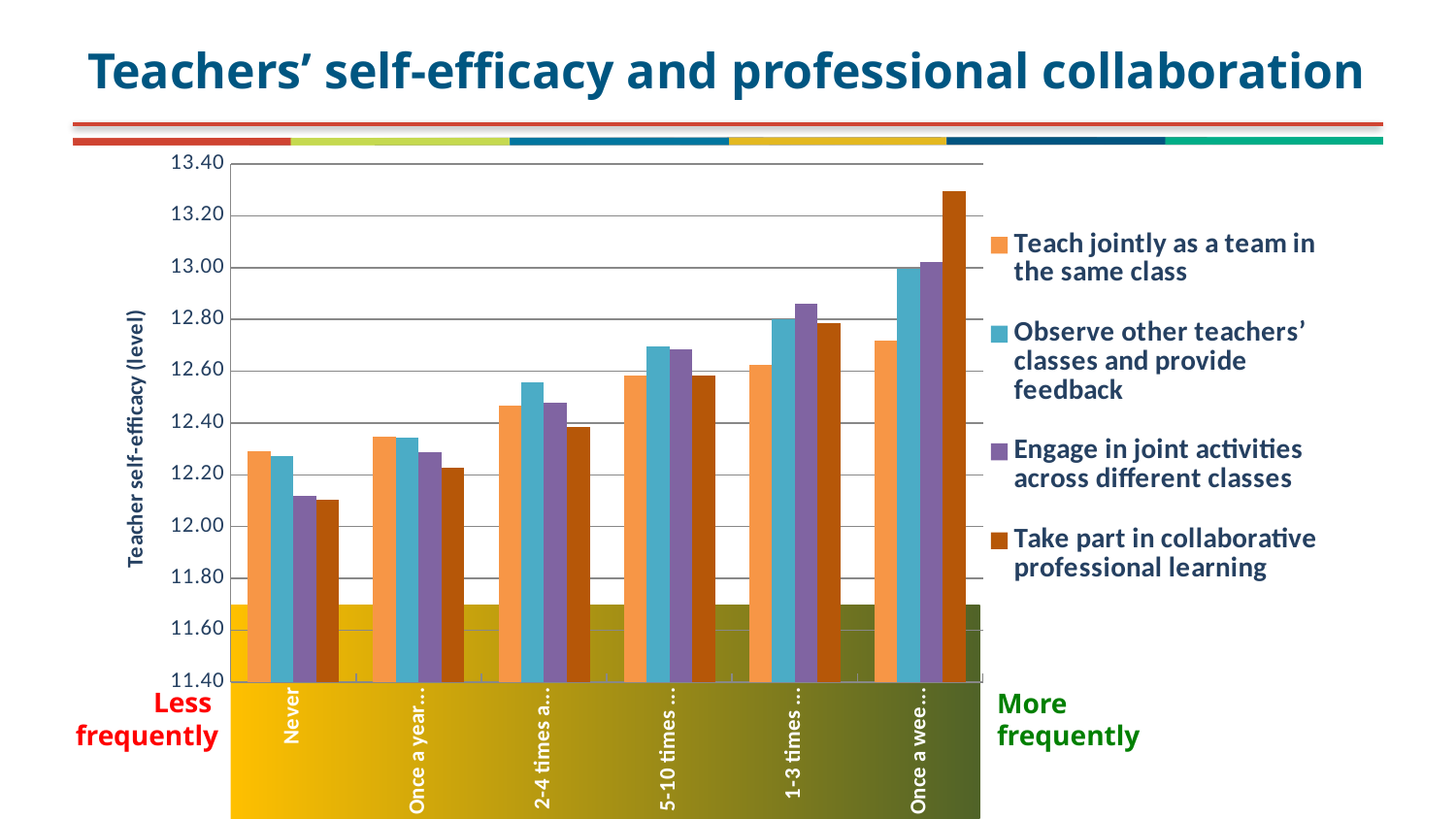
Is the value for 'Take part in collaborative professional learning' in the rightmost category greater or less than 13.20? greater Is the value for 'Take part in collaborative professional learning' in the 'Never' category greater or less than 12.20? less Do the values for 'Take part in collaborative professional learning' rise or fall from left to right along the x axis? rise Is the value for 'Teach jointly as a team in the same class' in the 'Never' category greater or less than 12.20? greater How many categories are shown along the x axis? 6 Which category has the highest value for 'Take part in collaborative professional learning'? the rightmost category (Once a wee...) In the 'Never' category, which is larger: 'Teach jointly as a team in the same class' or 'Take part in collaborative professional learning'? Teach jointly as a team in the same class What kind of chart is shown on the slide? bar chart How many series does the legend list? 4 What is the title of the slide? Teachers' self-efficacy and professional collaboration Which category has the lowest value for 'Engage in joint activities across different classes'? Never What is the label of the vertical axis? Teacher self-efficacy (level)